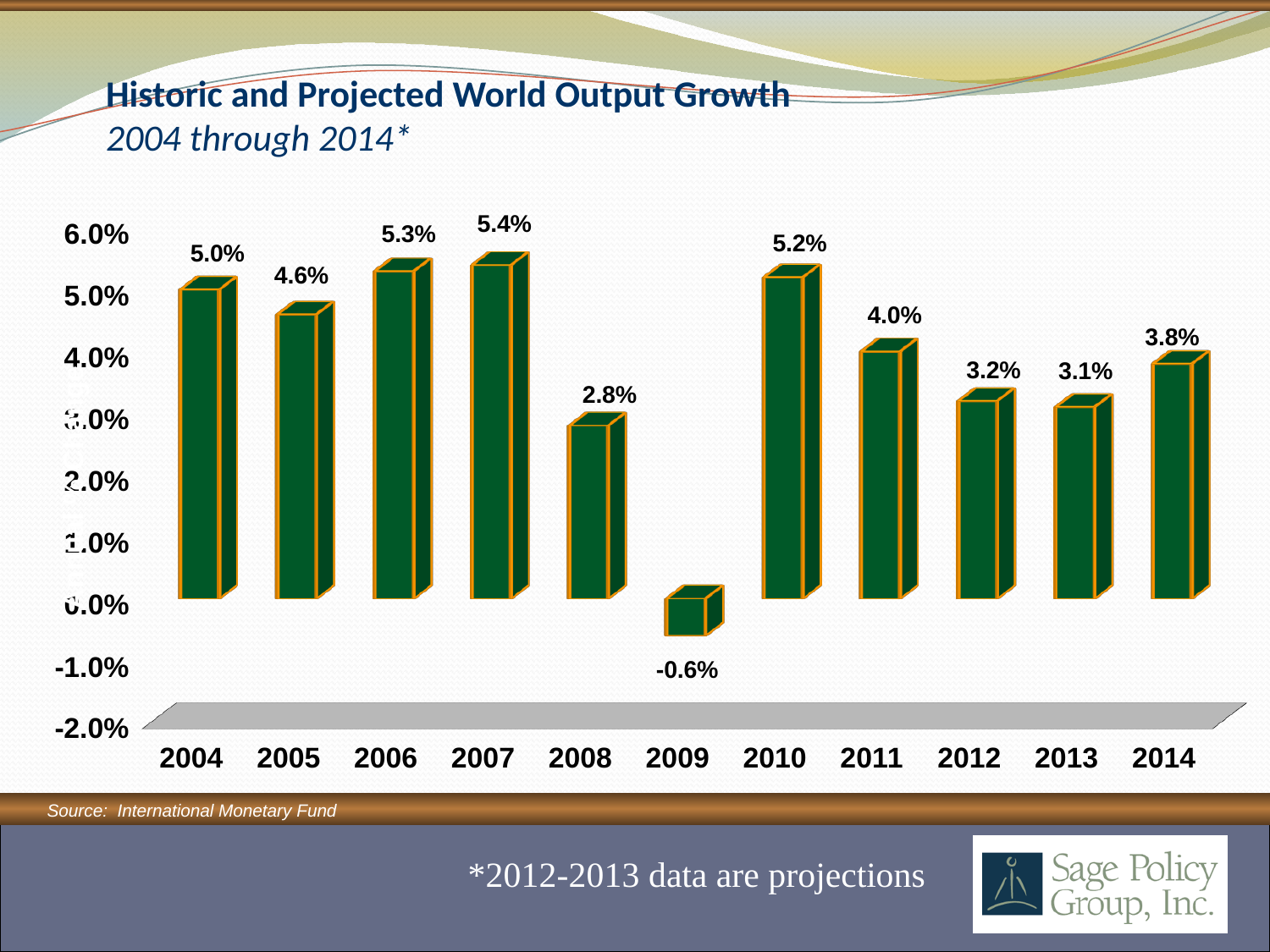
Is the value for 2005 greater or less than 4.0%? greater What is the world output growth value for 2014? 3.8% What kind of chart is shown on the slide? bar chart Which year has the highest world output growth? 2007 Do the values rise or fall from 2011 to 2013? fall What is the world output growth value for 2009? -0.6% What is the difference between the 2010 value and the 2011 value? 1.2% What is the world output growth value for 2007? 5.4% Which year has the lowest world output growth? 2009 Which year has the larger value, 2008 or 2012? 2012 How many years are shown on the x axis? 11 What is the source cited for the chart data? International Monetary Fund